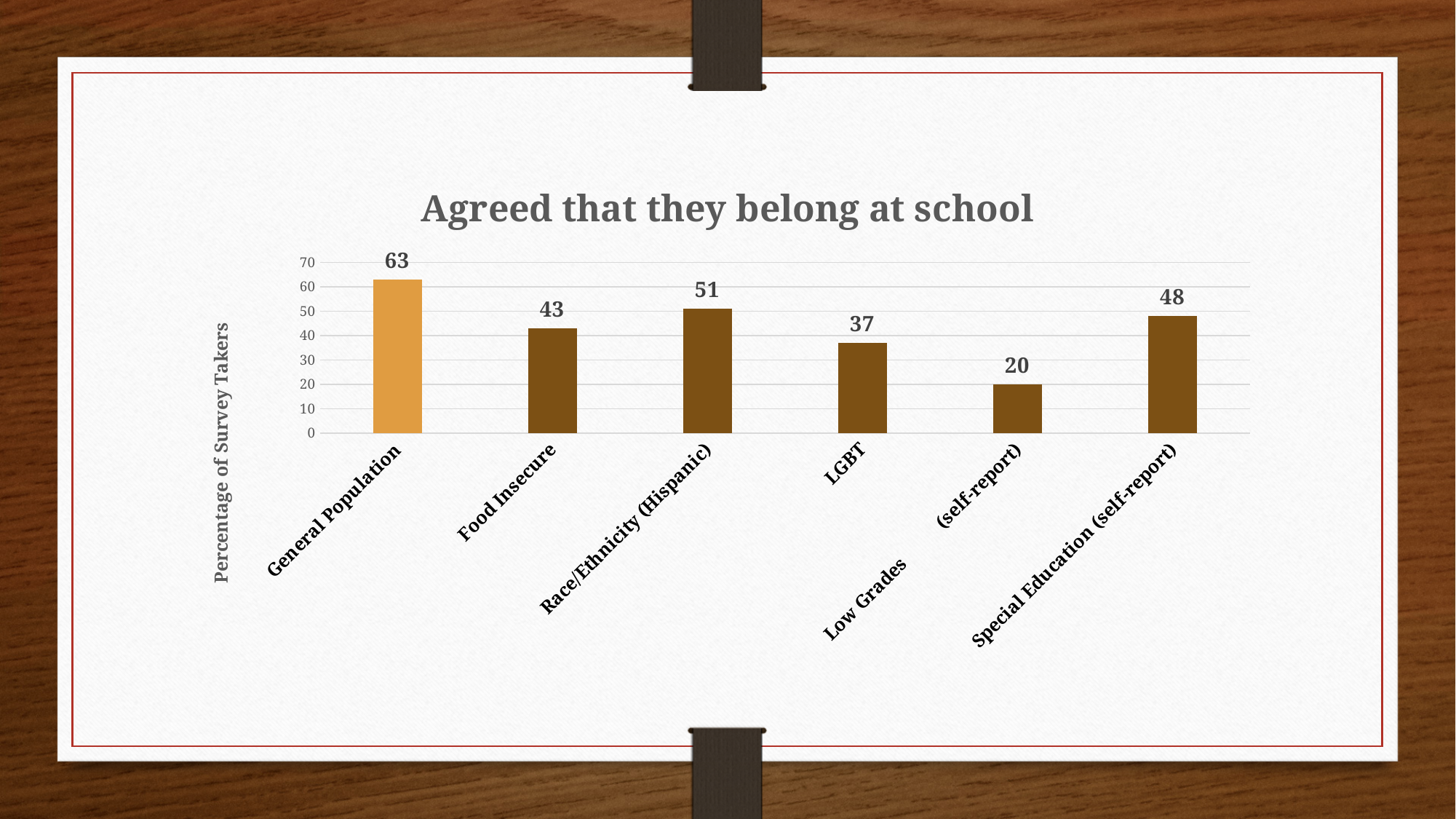
How many categories are shown in the chart? 6 What is the value for Special Education (self-report)? 48 What is the value for General Population? 63 What kind of chart is shown on the slide? bar chart What is the label of the vertical axis? Percentage of Survey Takers What is the value for Food Insecure? 43 Which category has the lowest value? Low Grades (self-report) What is the title of the chart? Agreed that they belong at school Which category has the highest value? General Population What is the value for Low Grades (self-report)? 20 What is the difference between the values for General Population and LGBT? 26 Which is larger, the value for Race/Ethnicity (Hispanic) or the value for Special Education (self-report)? Race/Ethnicity (Hispanic)